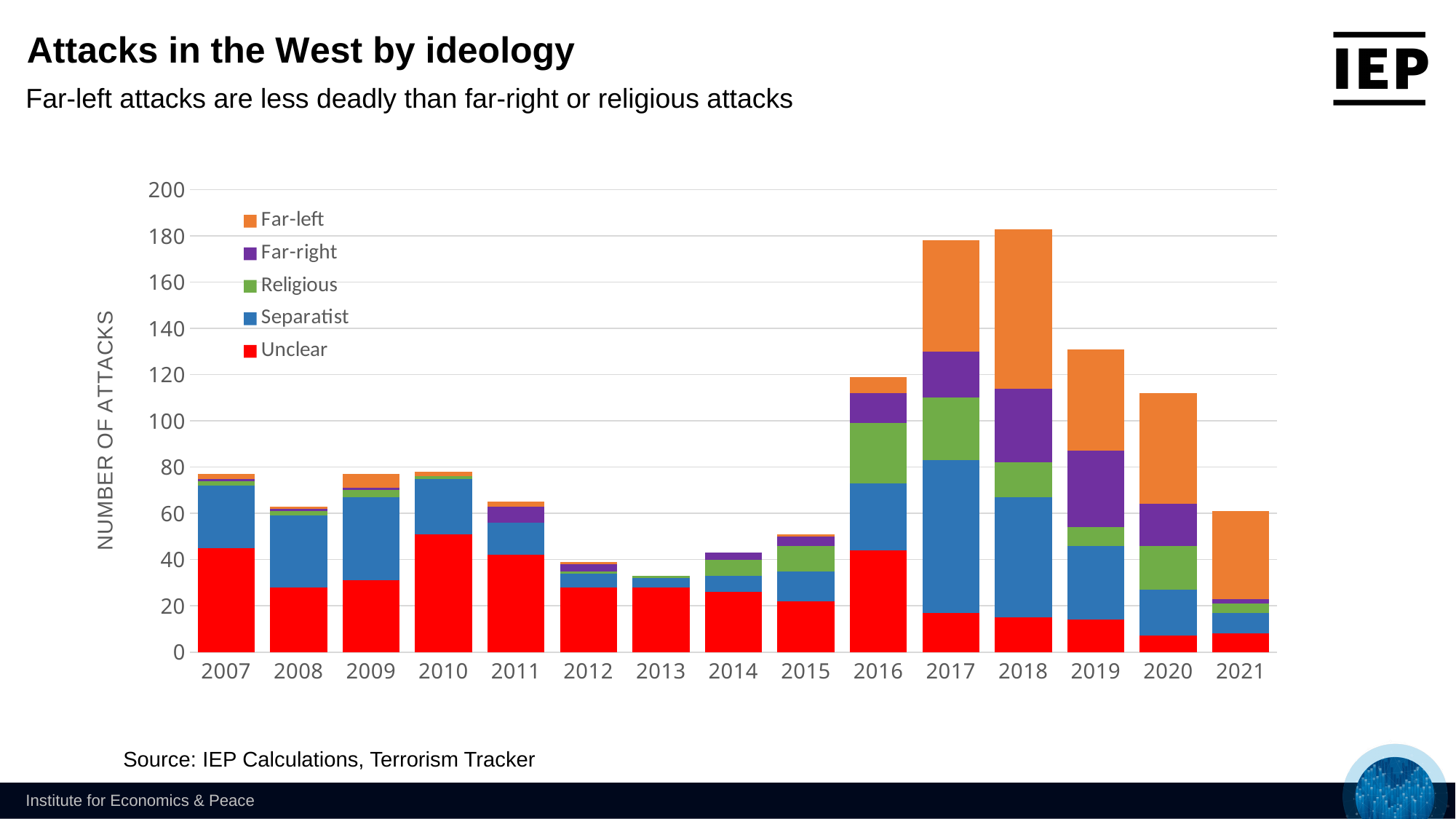
Do the total number of attacks rise or fall from 2018 to 2021? fall Is the total number of attacks in 2019 greater or less than 120? greater Is the total number of attacks in 2021 greater or less than 80? less What is the label on the y axis of the chart? NUMBER OF ATTACKS What kind of chart is shown on the slide? Stacked bar chart Which year has the lowest total number of attacks? 2013 Which year has a larger total number of attacks, 2007 or 2017? 2017 What is the title of the chart on the slide? Attacks in the West by ideology How many years are shown along the x axis of the chart? 15 How many series does the legend list? 5 Is the total number of attacks in 2016 greater or less than 100? greater Which year has the highest total number of attacks? 2018